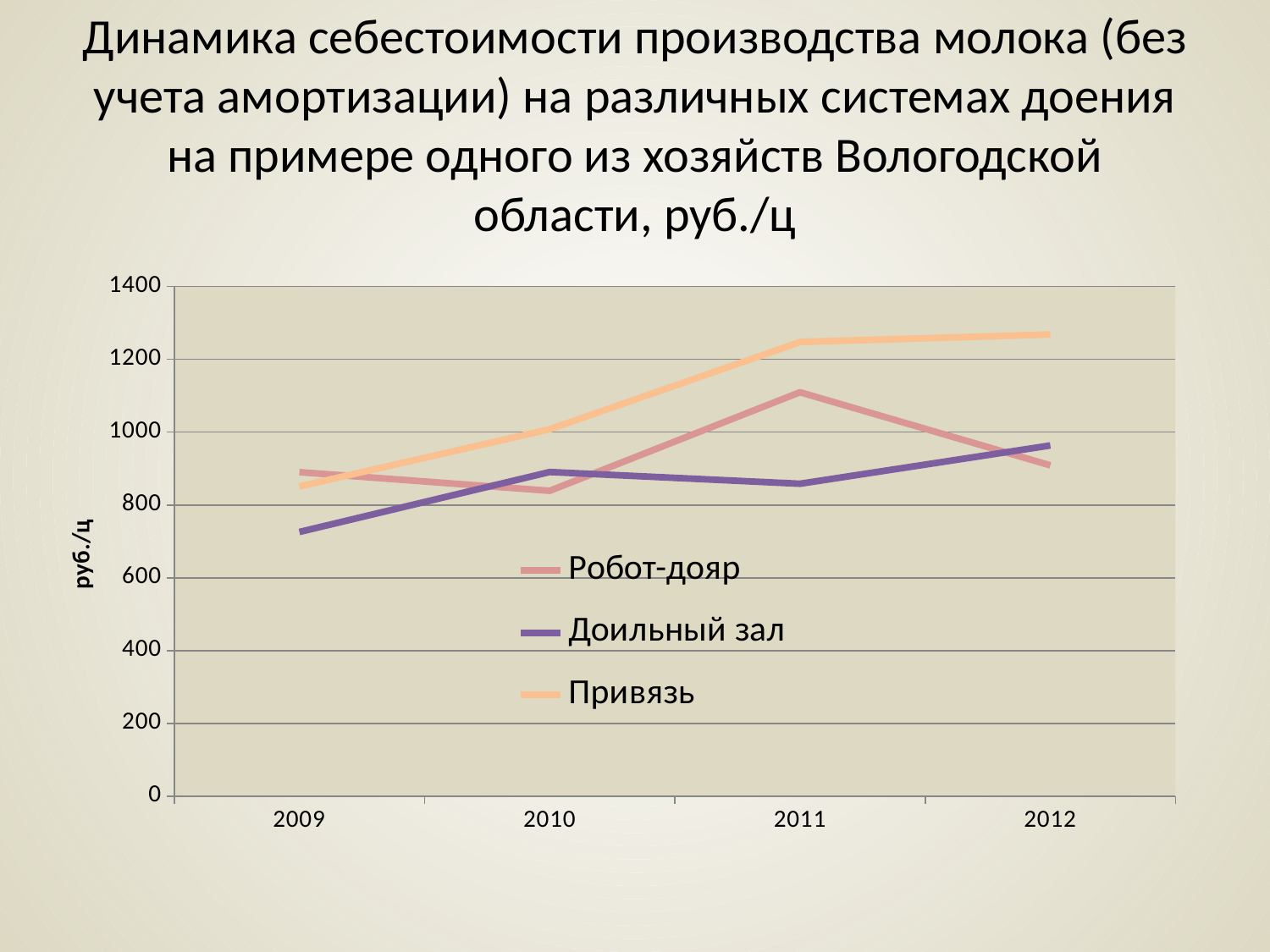
What kind of chart is shown on the slide? line chart Is the value for Привязь in 2011 greater or less than 1200? greater How many series does the legend list? 3 In which year is the value for Робот-дояр highest? 2011 Is the value for Робот-дояр in 2011 greater or less than 1000? greater Does the value for Привязь rise or fall from 2009 to 2012? rise In which year is the value for Доильный зал lowest? 2009 Is the value for Доильный зал in 2009 greater or less than 800? less How many years are shown on the x axis? 4 In 2009, which series has the larger value: Робот-дояр or Доильный зал? Робот-дояр In 2011, which series has the larger value: Привязь or Робот-дояр? Привязь